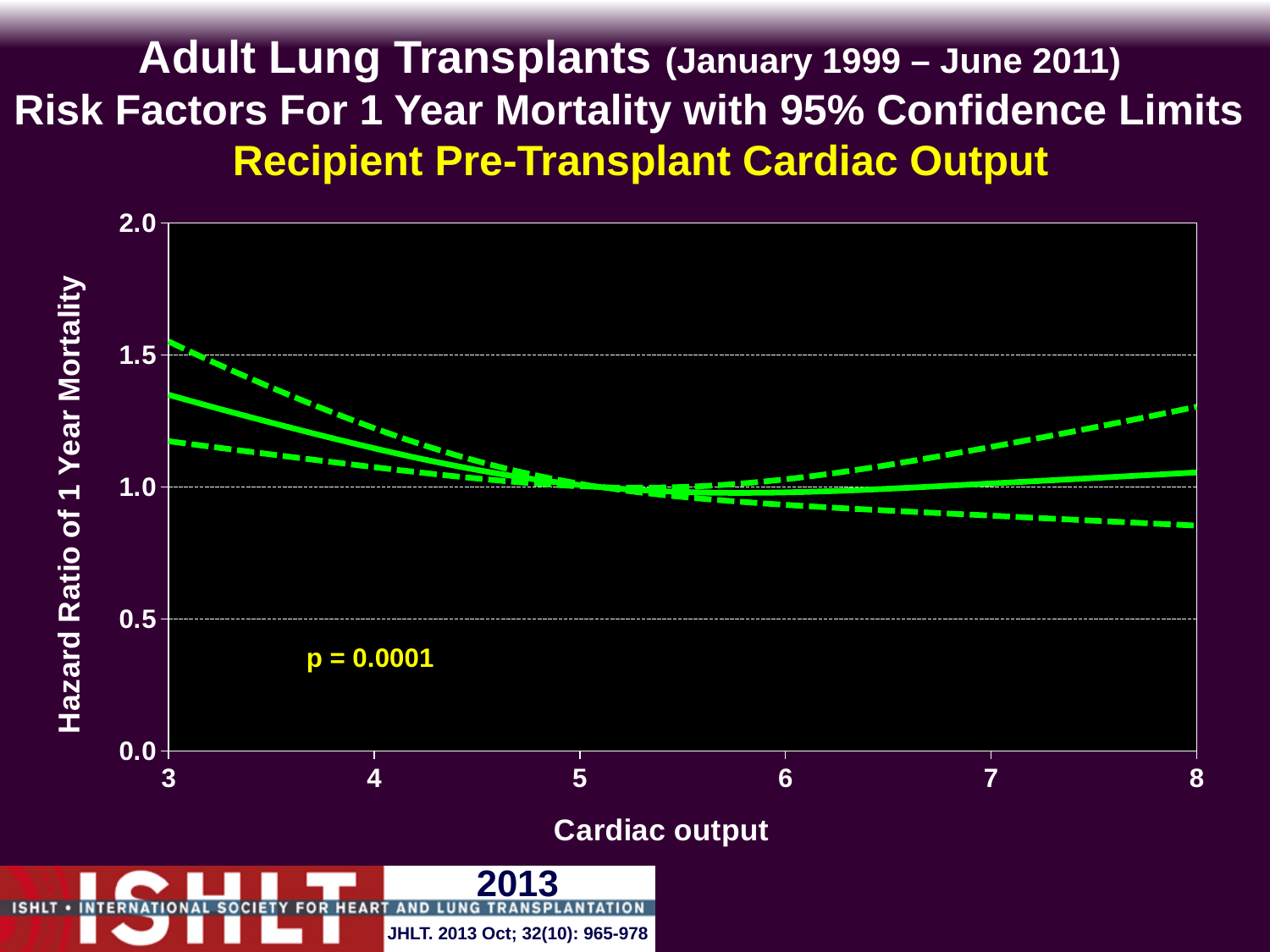
What is the label of the x axis? Cardiac output At a cardiac output of 8, is the solid hazard ratio line greater or less than 1.5? less How many lines are plotted on the chart? 3 What is the highest value shown on the y axis? 2.0 Is the solid hazard ratio line higher at a cardiac output of 3 or at a cardiac output of 8? 3 At a cardiac output of 3, is the solid hazard ratio line greater or less than 1.0? greater What is the label of the y axis? Hazard Ratio of 1 Year Mortality What kind of chart is shown on the slide? line chart At a cardiac output of 8, is the lower dashed confidence limit greater or less than 1.0? less What p-value is printed on the chart? p = 0.0001 Does the solid hazard ratio line rise or fall as cardiac output increases from 3 to 5? fall